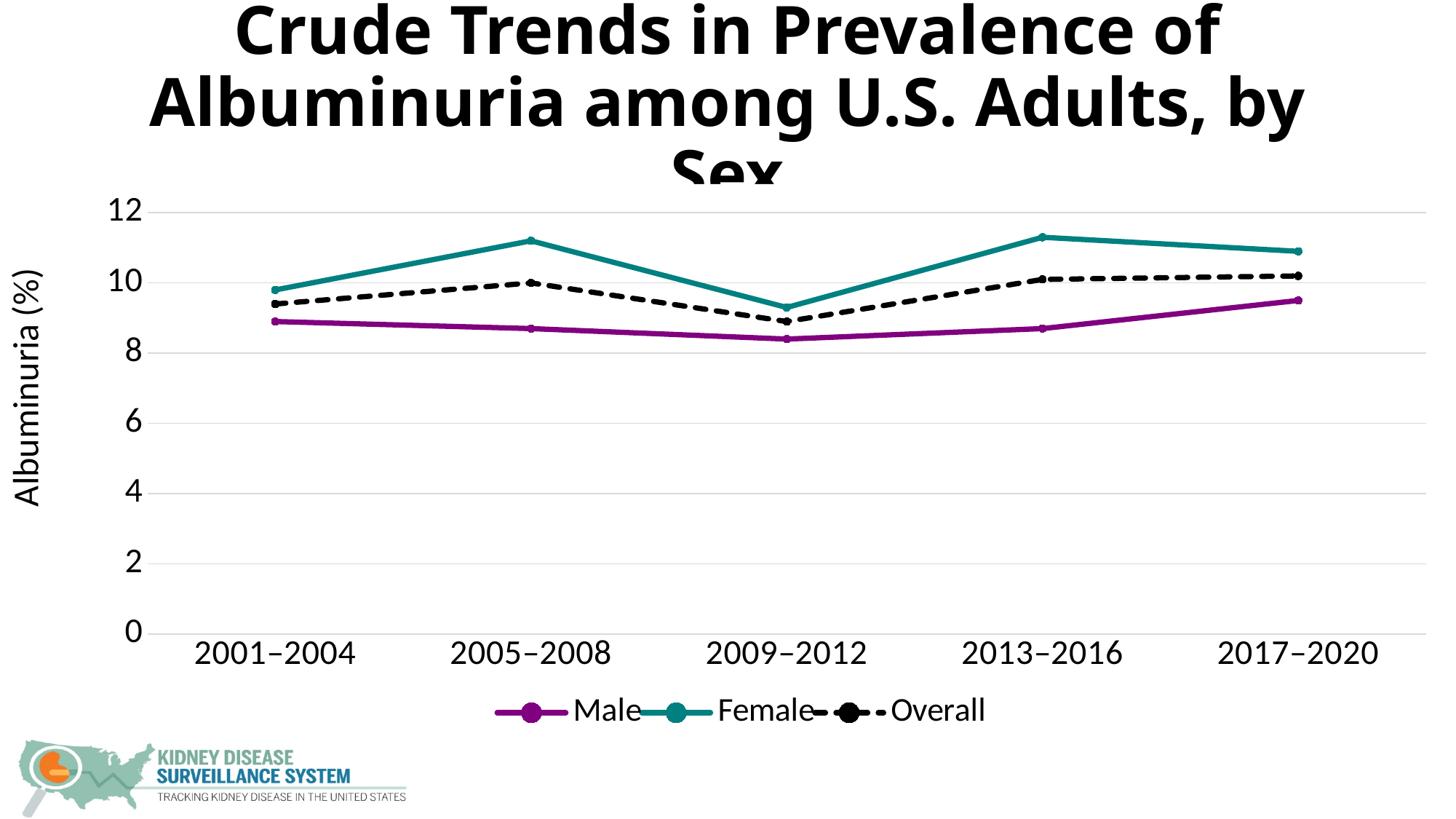
Which series has the lowest values across all periods? Male Is the value for Female in 2005–2008 greater or less than 10? greater How many series does the legend list? 3 In which period is the Male value highest? 2017–2020 Which series has the highest values across all periods? Female Is the value for Female in 2013–2016 greater or less than 10? greater Is the value for Male in 2009–2012 greater or less than 10? less How many time periods are shown on the x axis? 5 What kind of chart is shown on the slide? Line chart In 2005–2008, which is larger, the Male value or the Female value? Female Does the Male line rise or fall from 2009–2012 to 2017–2020? Rise